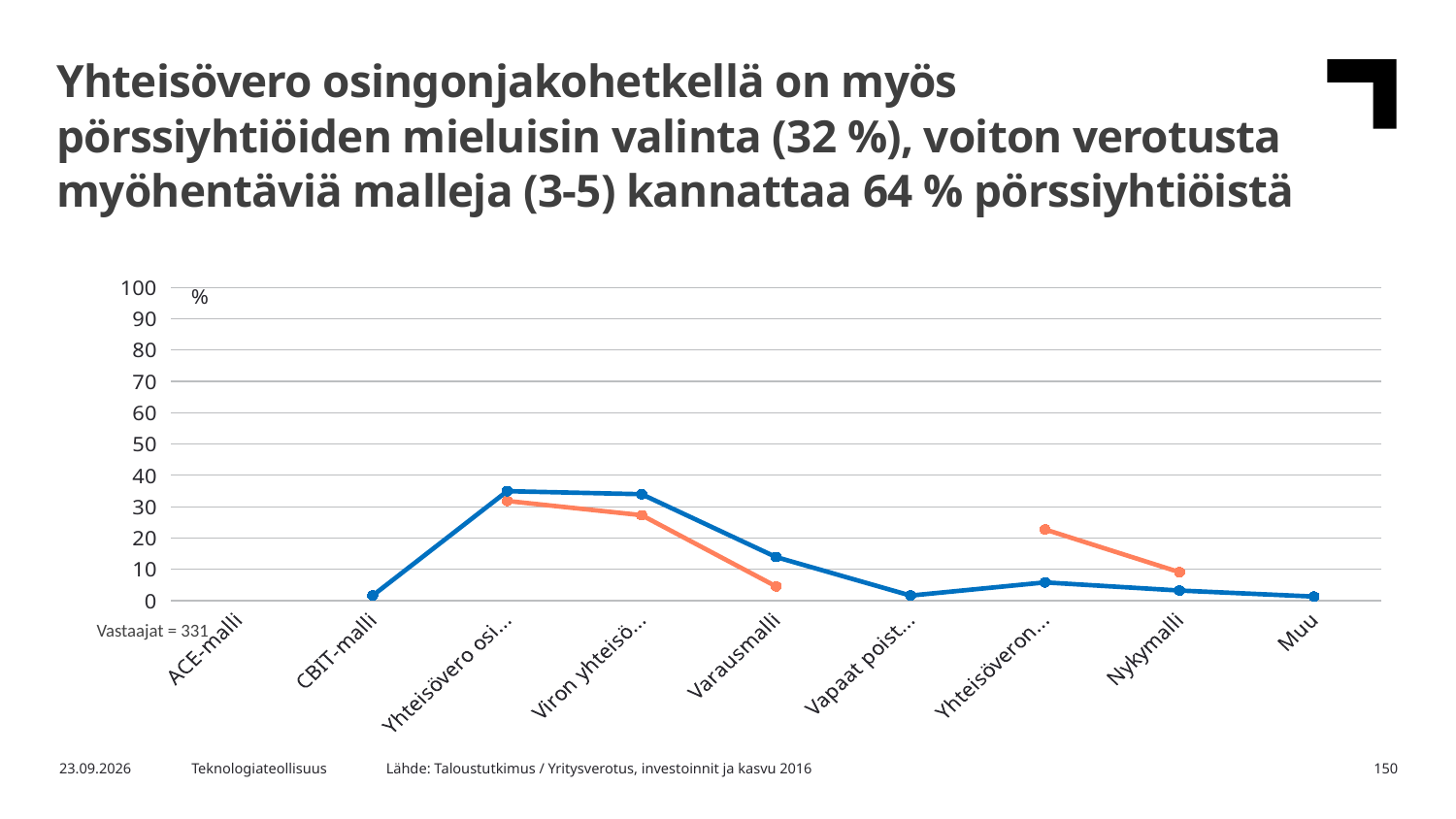
Is the value of the blue line for Nykymalli greater or less than 10? less For Varausmalli, which line has the larger value, the blue line or the orange line? the blue line For which category does the orange line reach its lowest value? Varausmalli For Yhteisöveron..., which line has the larger value, the blue line or the orange line? the orange line What kind of chart is shown on the slide? line chart Is the value of the blue line for Varausmalli greater or less than 10? greater Is the value of the orange line for Varausmalli greater or less than 10? less What unit is shown at the top of the y axis of the chart? % How many categories are shown on the x axis of the chart? 9 Does the blue line rise or fall from Viron yhteisö... to Vapaat poist...? fall